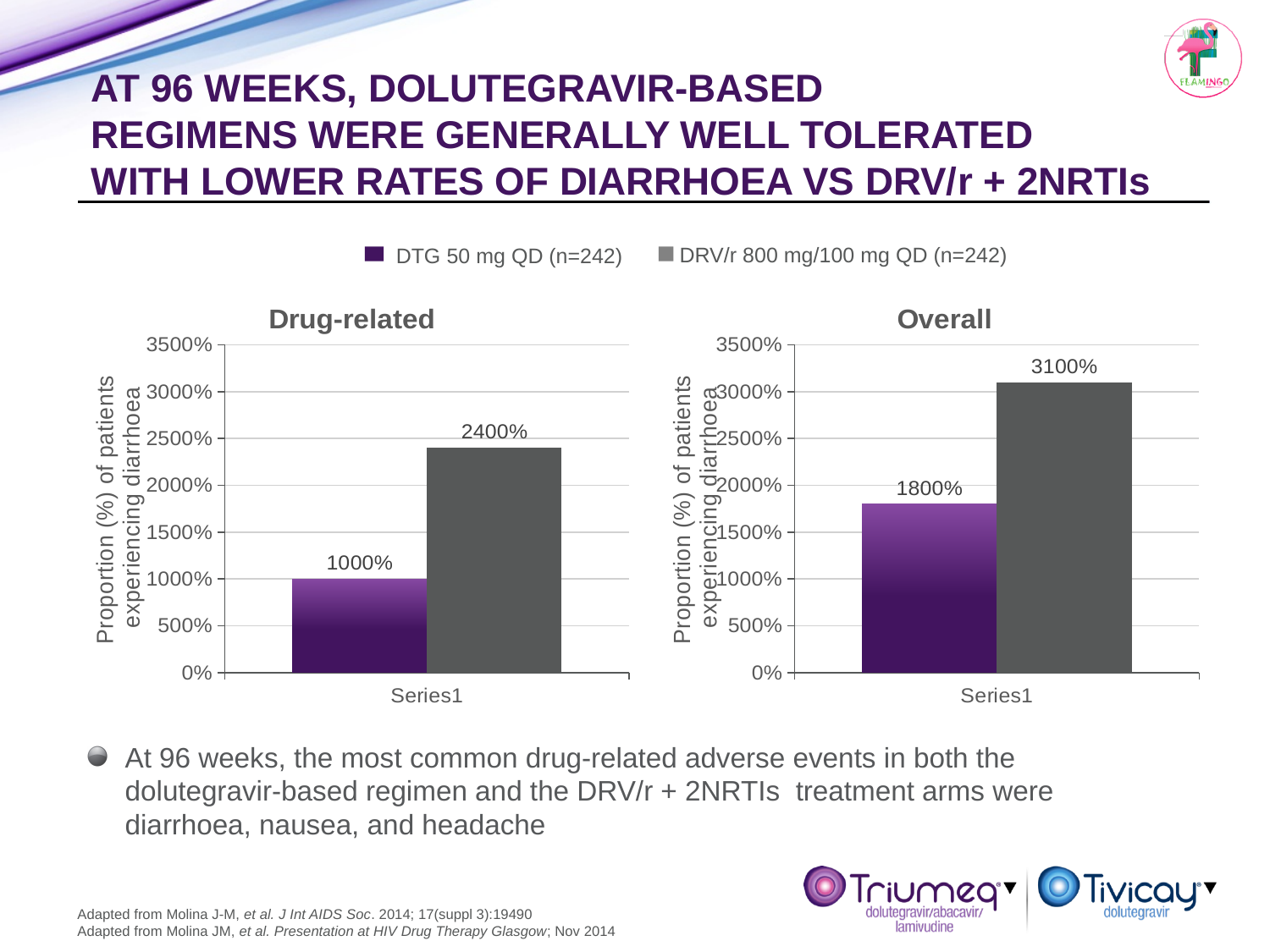
In the Overall chart, what is the value for DTG 50 mg QD (n=242)? 1800% What kind of chart is the Overall chart? bar chart In the Drug-related chart, which series has the higher value? DRV/r 800 mg/100 mg QD (n=242) What colour are the DTG 50 mg QD (n=242) bars? purple In the Overall chart, what is the difference between the DRV/r 800 mg/100 mg QD value and the DTG 50 mg QD value? 1300% In the Overall chart, which series has the lower value? DTG 50 mg QD (n=242) Is the DTG 50 mg QD value in the Overall chart larger or smaller than the DTG 50 mg QD value in the Drug-related chart? larger How many series does the legend list? 2 In the Drug-related chart, what is the value for DTG 50 mg QD (n=242)? 1000% In the Overall chart, what is the value for DRV/r 800 mg/100 mg QD (n=242)? 3100% In the Drug-related chart, what is the difference between the DRV/r 800 mg/100 mg QD value and the DTG 50 mg QD value? 1400% In the Drug-related chart, what is the value for DRV/r 800 mg/100 mg QD (n=242)? 2400%